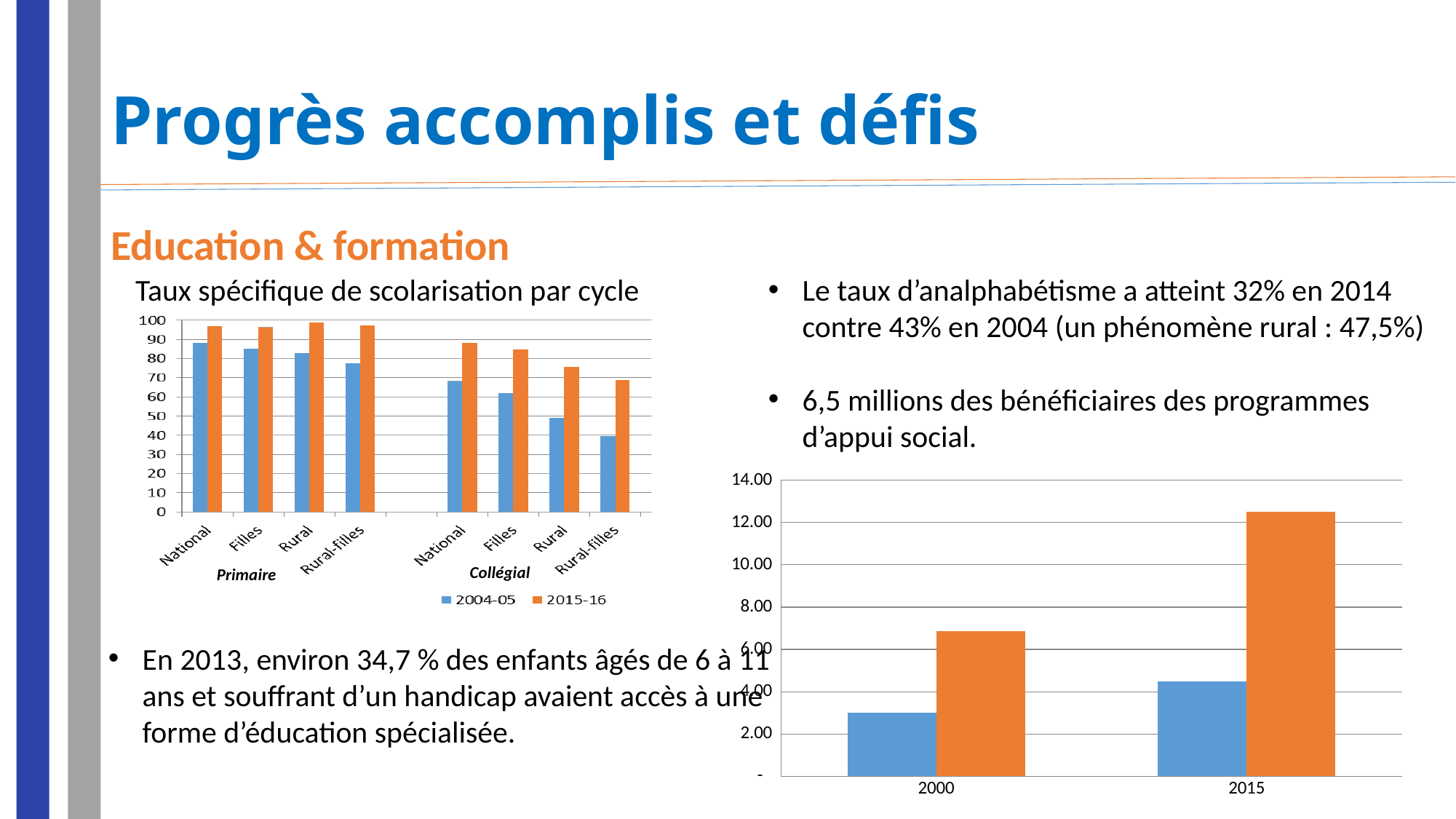
In the bar chart at the bottom right of the slide, is the orange bar for 2015 greater or less than 12.00? greater In the 'Taux spécifique de scolarisation par cycle' chart, which cycle group has the higher values overall, Primaire or Collégial? Primaire How many series does the legend of the 'Taux spécifique de scolarisation par cycle' chart list? 2 In the 'Taux spécifique de scolarisation par cycle' chart, which is larger for Rural in Collégial: the 2004-05 value or the 2015-16 value? 2015-16 What are the two series named in the legend of the 'Taux spécifique de scolarisation par cycle' chart? 2004-05 and 2015-16 What kind of chart is the 'Taux spécifique de scolarisation par cycle' chart? bar chart In the bar chart at the bottom right of the slide, how many categories are shown on the x axis? 2 In the 'Taux spécifique de scolarisation par cycle' chart, which category has the lowest 2004-05 value? Rural-filles (Collégial) In the 'Taux spécifique de scolarisation par cycle' chart, is the 2004-05 value for Rural-filles in Collégial greater or less than 50? less In the bar chart at the bottom right of the slide, do the values rise or fall from 2000 to 2015? rise In the 'Taux spécifique de scolarisation par cycle' chart, is the 2015-16 value for National in Primaire greater or less than 90? greater In the 'Taux spécifique de scolarisation par cycle' chart, how many categories are shown on the x axis? 8